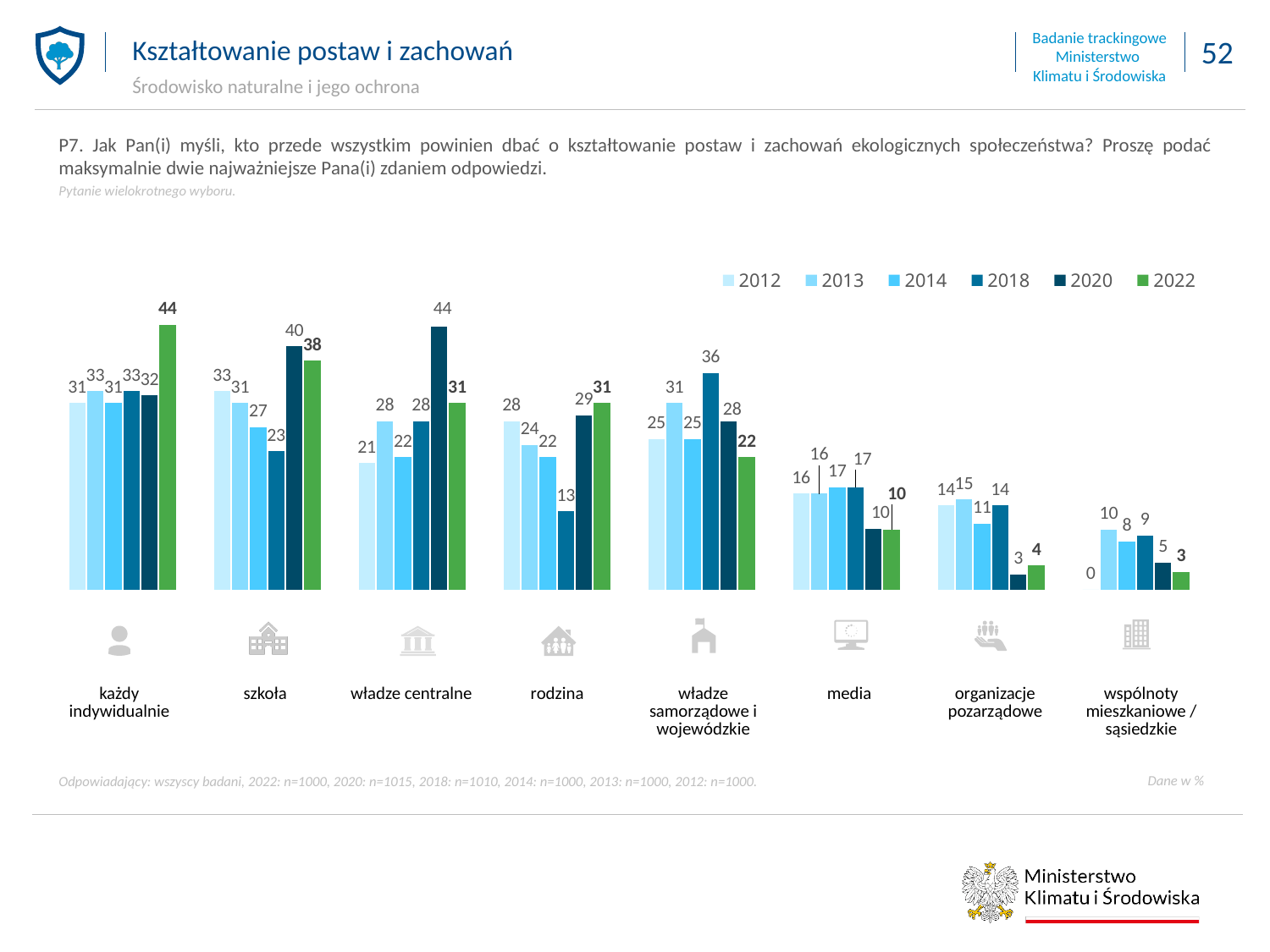
How many series does the legend list? 6 How many categories are shown on the x axis? 8 What is the difference between the 2020 and 2022 values for "szkoła"? 2 Which category has the highest 2018 value? władze samorządowe i wojewódzkie What is the difference between the 2022 values for "każdy indywidualnie" and "władze samorządowe i wojewódzkie"? 22 Which category has the lowest 2022 value? wspólnoty mieszkaniowe / sąsiedzkie What is the 2012 value for "wspólnoty mieszkaniowe / sąsiedzkie"? 0 What is the 2018 value for "rodzina"? 13 What is the 2022 value for "każdy indywidualnie"? 44 What is the 2020 value for "władze centralne"? 44 Which is larger for "media": the 2014 value or the 2022 value? 2014 What kind of chart is shown on the slide? bar chart